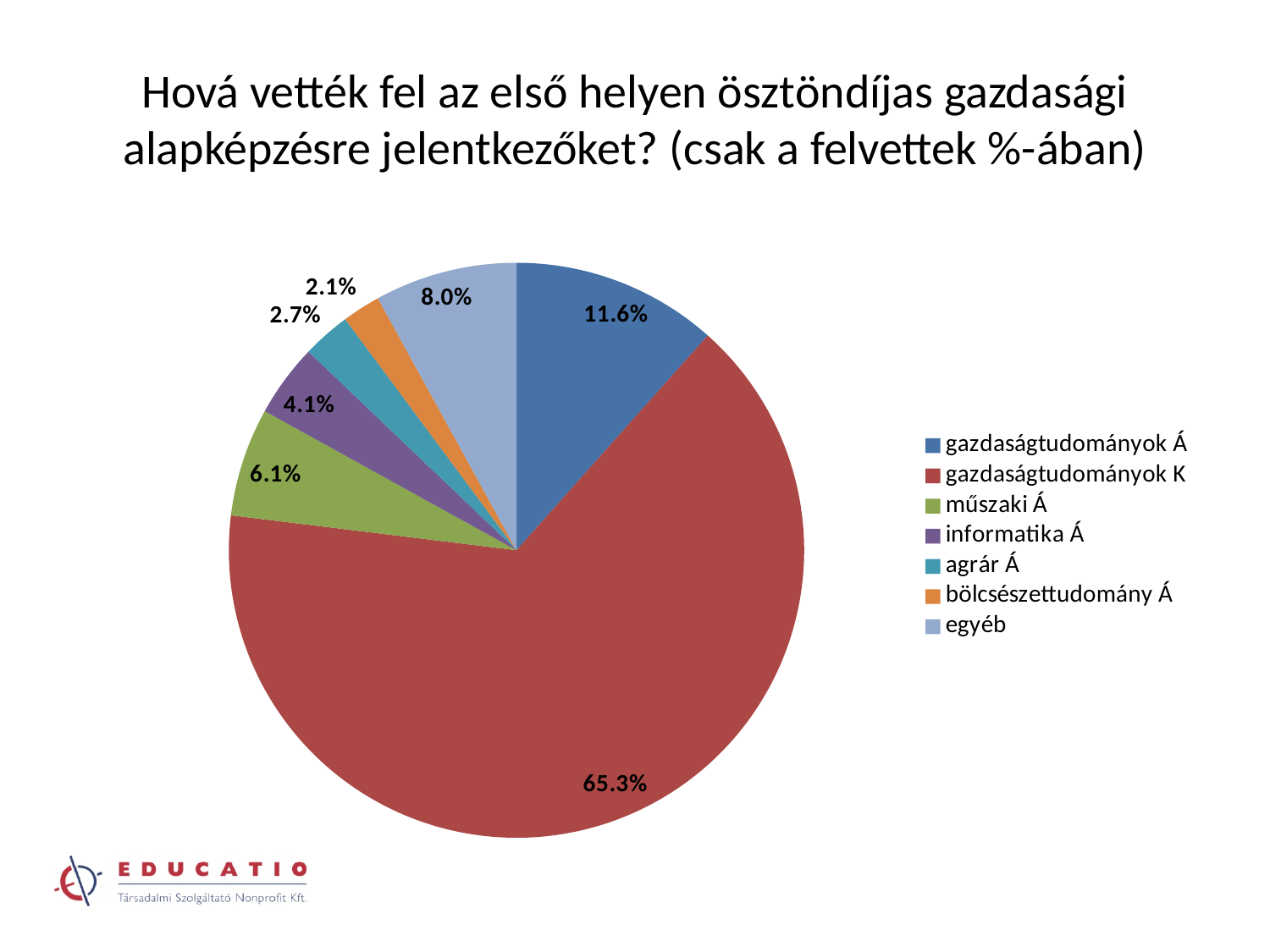
What kind of chart is shown on the slide? pie chart How many categories does the legend list? 7 What is the difference between the values for gazdaságtudományok K and gazdaságtudományok Á? 53.7% What is the value for egyéb? 8.0% What is the value for informatika Á? 4.1% Which category has the smallest slice of the pie? bölcsészettudomány Á What is the value for agrár Á? 2.7% What share of the pie does gazdaságtudományok K have? 65.3% What is the value for gazdaságtudományok Á? 11.6% What is the value for bölcsészettudomány Á? 2.1% What is the value for műszaki Á? 6.1% Which category has the largest slice of the pie? gazdaságtudományok K